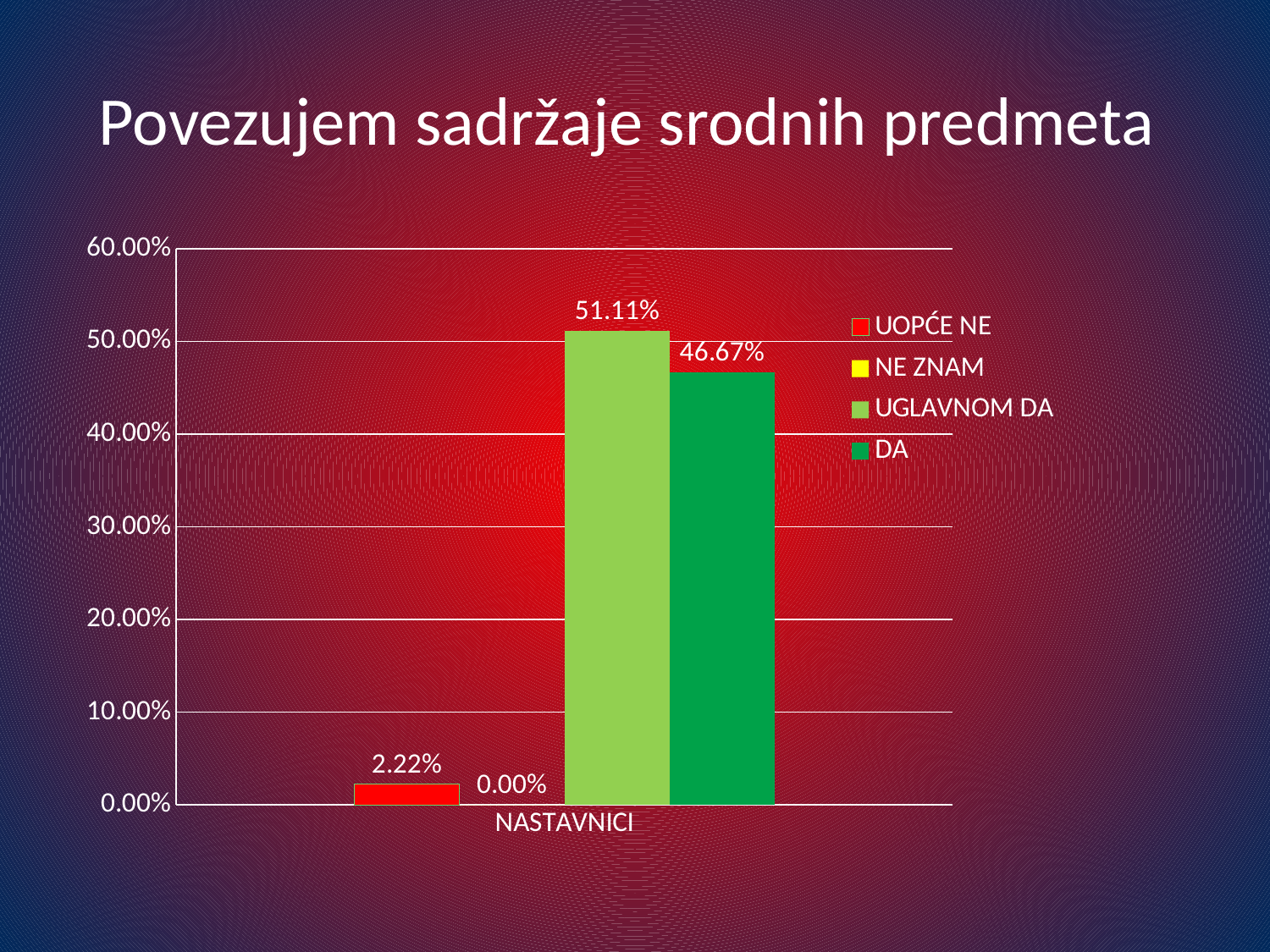
How many series does the legend list? 4 What is the value for UGLAVNOM DA in the NASTAVNICI category? 51.11% Which is larger, the value for DA or the value for UOPĆE NE? DA What is the value for NE ZNAM in the NASTAVNICI category? 0.00% What kind of chart is shown on the slide? bar chart What is the title of the chart? Povezujem sadržaje srodnih predmeta Is the value for DA greater or less than 40.00%? greater Which series has the lowest value? NE ZNAM Which series has the highest value? UGLAVNOM DA What is the value for DA in the NASTAVNICI category? 46.67% What is the value for UOPĆE NE in the NASTAVNICI category? 2.22% What is the difference between the UGLAVNOM DA and DA values? 4.44%